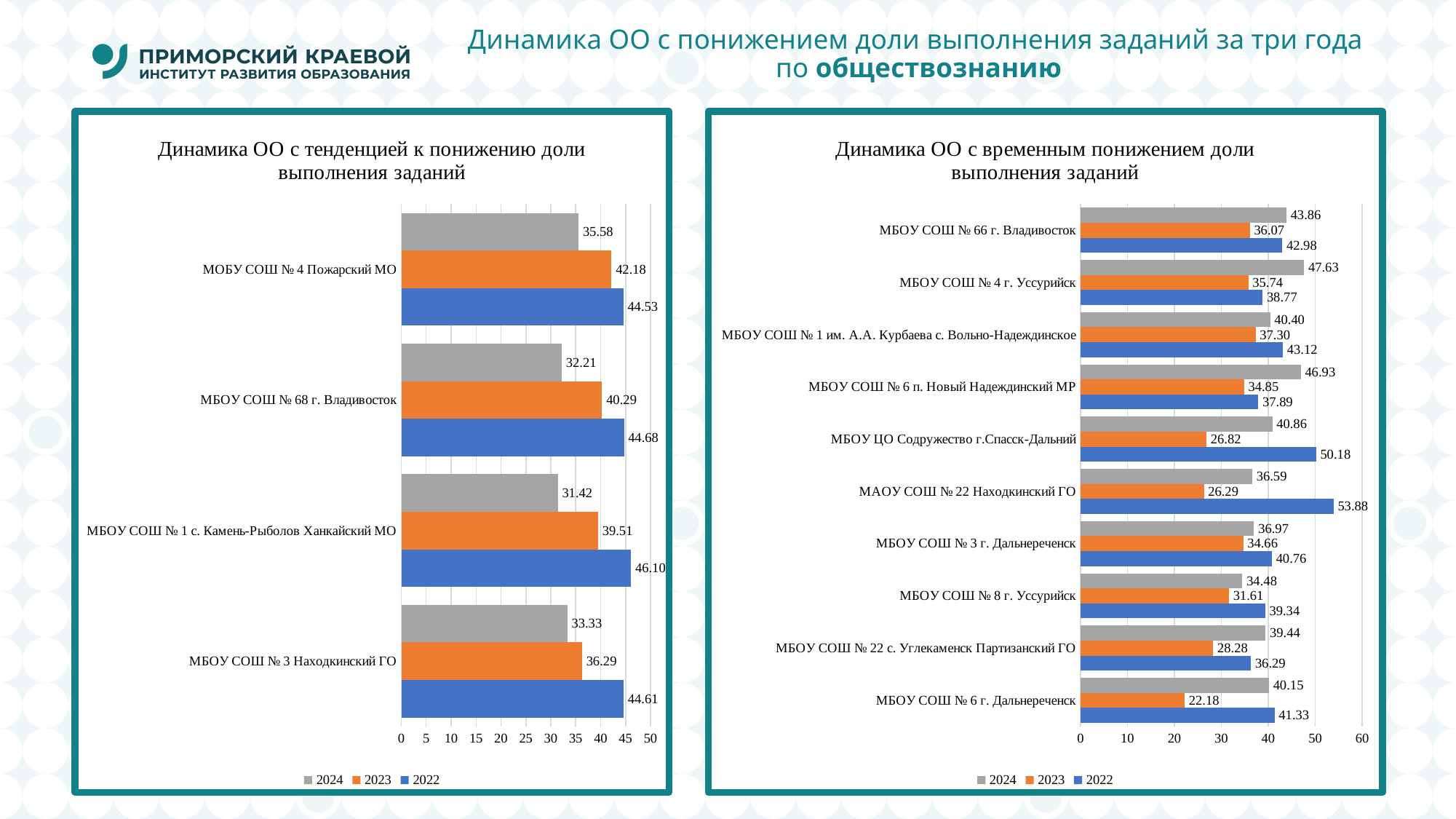
In the left chart (Динамика ОО с тенденцией к понижению доли выполнения заданий), what is the 2022 value for МБОУ СОШ № 1 с. Камень-Рыболов Ханкайский МО? 46.10 In the left chart (Динамика ОО с тенденцией к понижению доли выполнения заданий), how many schools are shown? 4 In the right chart (Динамика ОО с временным понижением доли выполнения заданий), which is larger for МБОУ СОШ № 66 г. Владивосток: the 2024 value or the 2022 value? 2024 In the right chart (Динамика ОО с временным понижением доли выполнения заданий), how many series does the legend list? 3 In the left chart (Динамика ОО с тенденцией к понижению доли выполнения заданий), what is the difference between the 2022 and 2024 values for МБОУ СОШ № 68 г. Владивосток? 12.47 In the right chart (Динамика ОО с временным понижением доли выполнения заданий), which school has the highest 2022 value? МАОУ СОШ № 22 Находкинский ГО In the left chart (Динамика ОО с тенденцией к понижению доли выполнения заданий), which school has the lowest 2024 value? МБОУ СОШ № 1 с. Камень-Рыболов Ханкайский МО In the right chart (Динамика ОО с временным понижением доли выполнения заданий), how many schools are shown? 10 In the right chart (Динамика ОО с временным понижением доли выполнения заданий), what is the 2023 value for МБОУ СОШ № 6 г. Дальнереченск? 22.18 In the left chart (Динамика ОО с тенденцией к понижению доли выполнения заданий), what is the 2024 value for МОБУ СОШ № 4 Пожарский МО? 35.58 In the left chart (Динамика ОО с тенденцией к понижению доли выполнения заданий), do the values for МБОУ СОШ № 3 Находкинский ГО rise or fall from 2022 to 2024? fall What type of chart is the right chart (Динамика ОО с временным понижением доли выполнения заданий)? bar chart